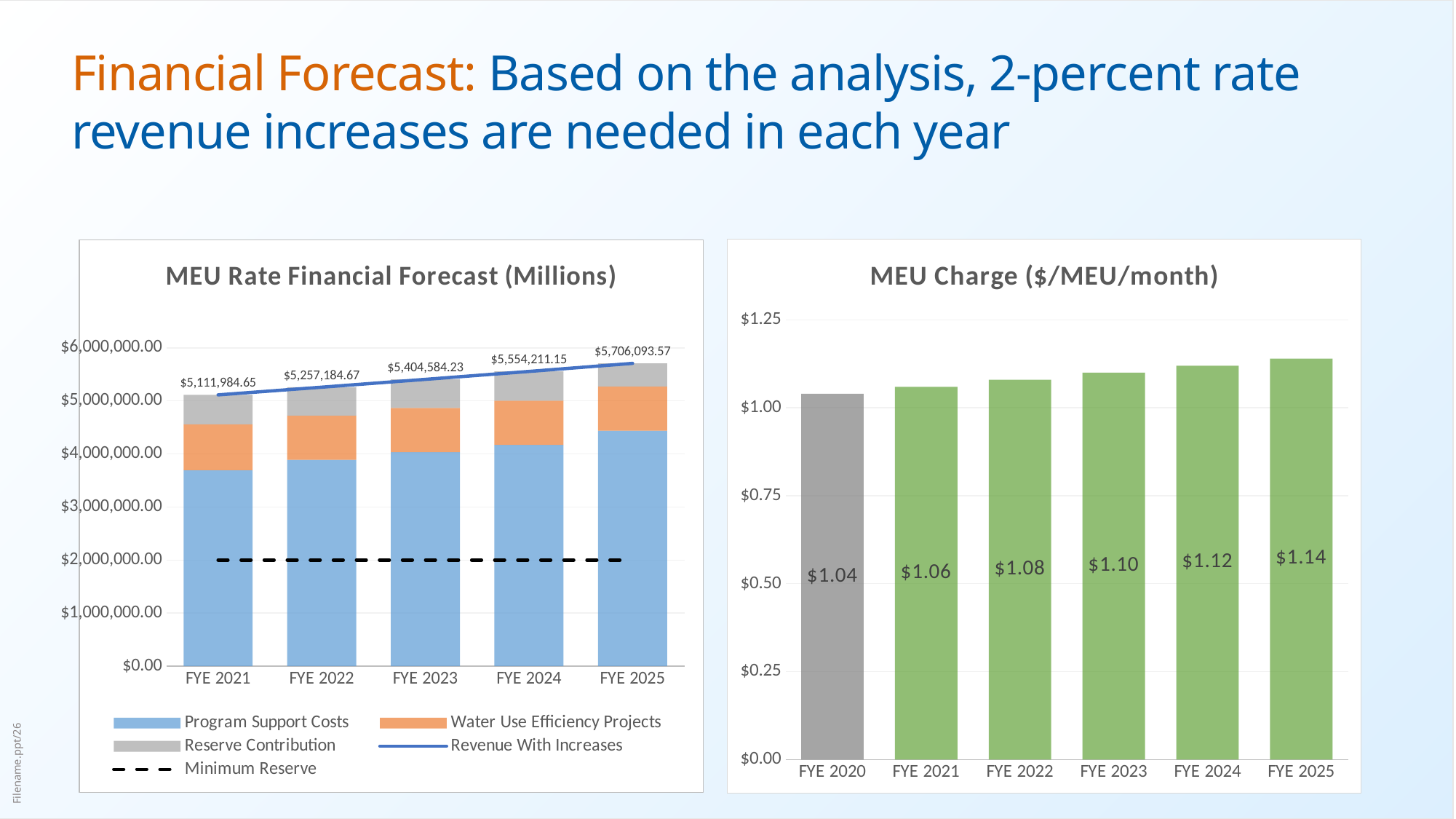
In the MEU Rate Financial Forecast (Millions) chart, what is the Revenue With Increases value for FYE 2025? $5,706,093.57 In the MEU Rate Financial Forecast (Millions) chart, how many series does the legend list? 5 In the MEU Rate Financial Forecast (Millions) chart, is the Program Support Costs value for FYE 2021 greater or less than $3,000,000.00? greater In the MEU Charge ($/MEU/month) chart, which year has the lowest charge? FYE 2020 In the MEU Charge ($/MEU/month) chart, do the values rise or fall from FYE 2020 to FYE 2025? rise In the MEU Rate Financial Forecast (Millions) chart, which series is shown as a dashed line? Minimum Reserve In the MEU Charge ($/MEU/month) chart, what is the value for FYE 2023? $1.10 In the MEU Charge ($/MEU/month) chart, which year has the highest charge? FYE 2025 What kind of chart is the MEU Charge ($/MEU/month) chart? bar chart In the MEU Charge ($/MEU/month) chart, what is the difference between the FYE 2025 and FYE 2020 values? $0.10 In the MEU Charge ($/MEU/month) chart, how many years are shown? 6 In the MEU Rate Financial Forecast (Millions) chart, what is the Revenue With Increases value for FYE 2023? $5,404,584.23